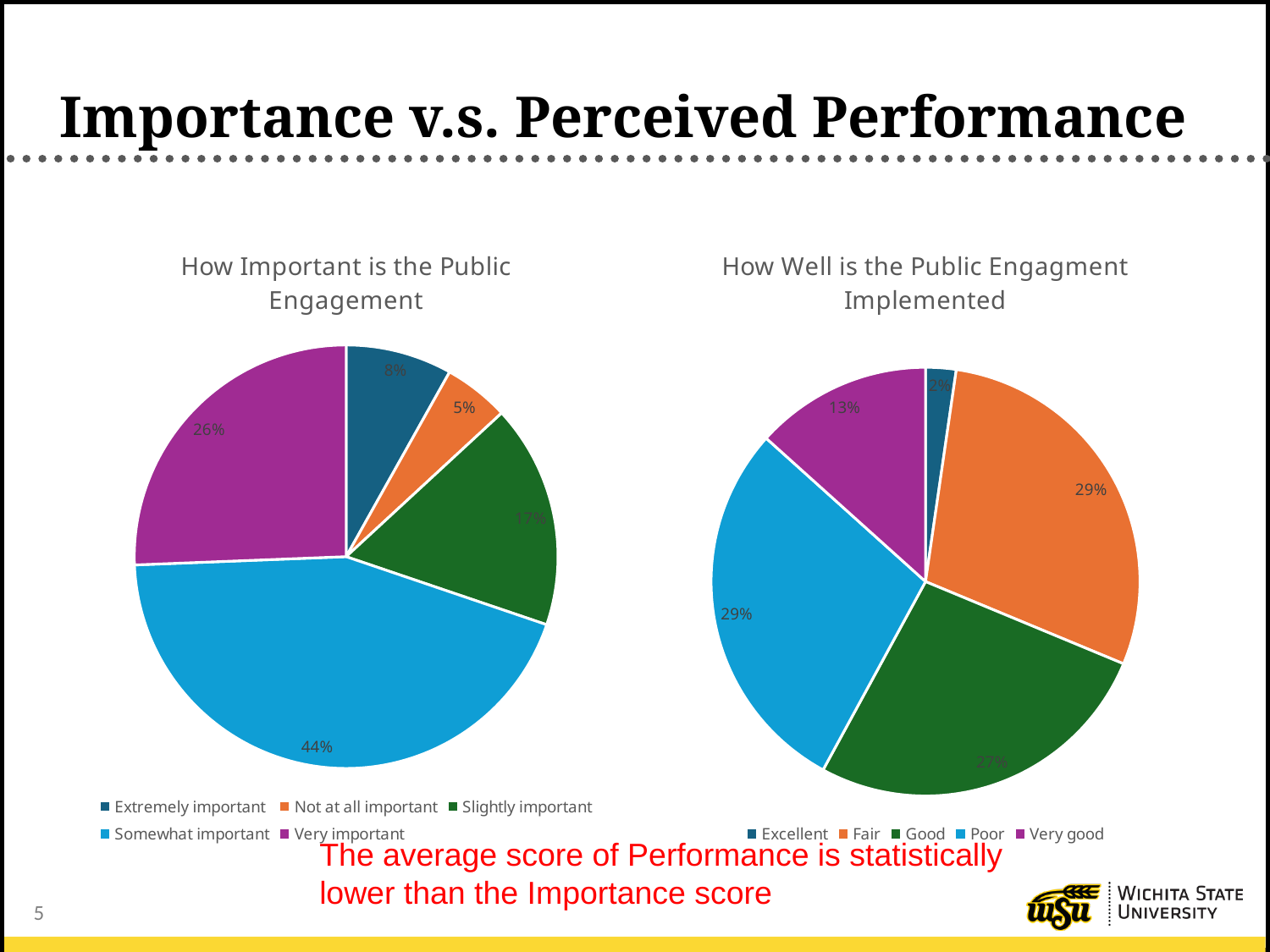
In the 'How Important is the Public Engagement' chart, what share is labelled for Not at all important? 5% In the 'How Important is the Public Engagement' chart, what share is labelled for Very important? 26% In the 'How Well is the Public Engagment Implemented' chart, what share is labelled for Very good? 13% In the 'How Important is the Public Engagement' chart, which category has the largest slice? Somewhat important What type of chart is used for 'How Important is the Public Engagement'? Pie chart In the 'How Well is the Public Engagment Implemented' chart, which category has the smallest slice? Excellent In the 'How Important is the Public Engagement' chart, what is the difference between the Somewhat important and Very important shares? 18% In the 'How Well is the Public Engagment Implemented' chart, what share is labelled for Good? 27% In the 'How Important is the Public Engagement' chart, what share is labelled for Somewhat important? 44% In the 'How Important is the Public Engagement' chart, which category has the smallest slice? Not at all important In the 'How Well is the Public Engagment Implemented' chart, which is larger, the Good slice or the Very good slice? Good How many categories does the legend of the 'How Well is the Public Engagment Implemented' chart list? 5